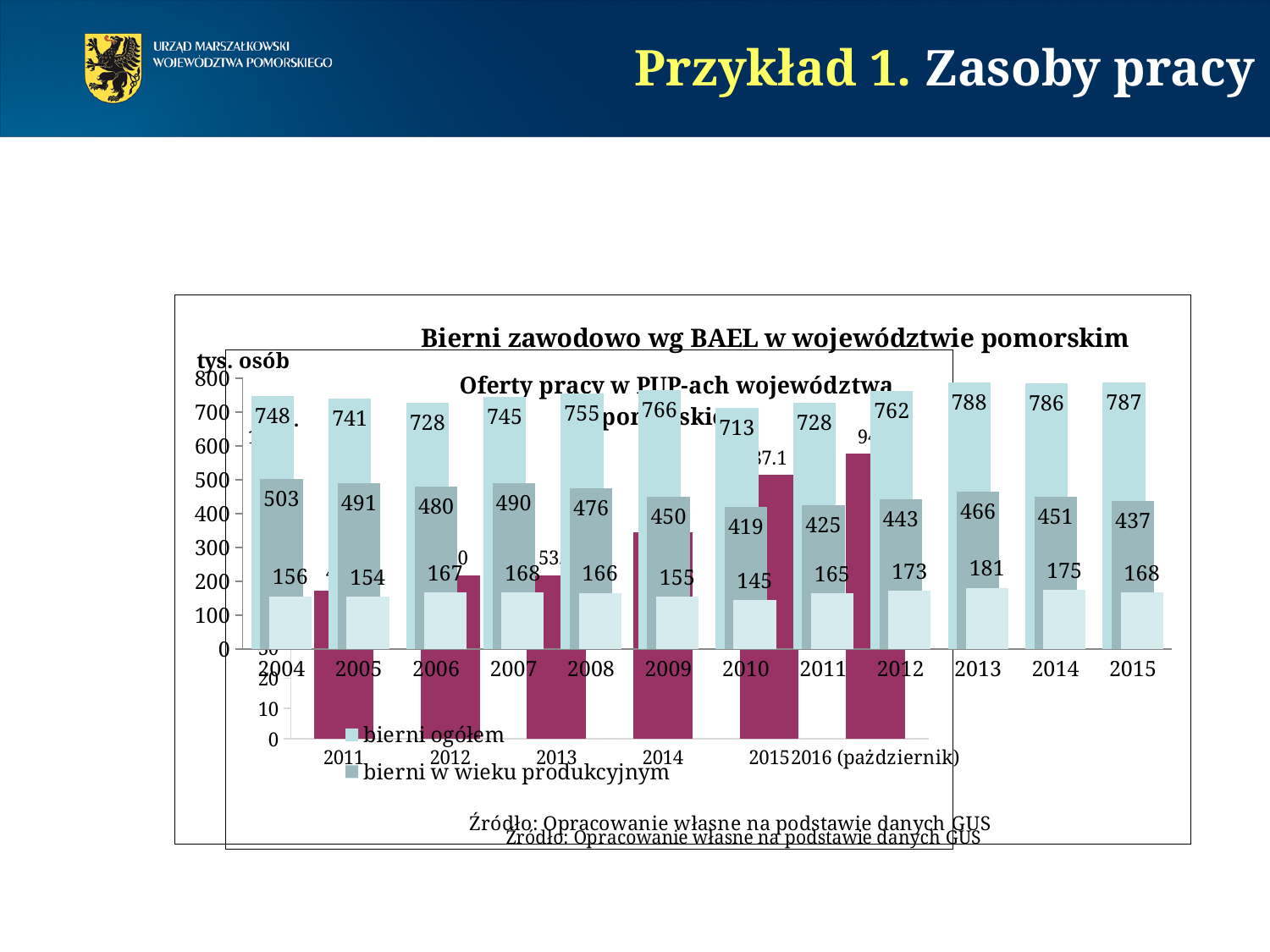
In the chart 'Bierni zawodowo wg BAEL w województwie pomorskim', is 'bierni w wieku produkcyjnym' larger in 2009 or in 2010? 2009 In the chart 'Bierni zawodowo wg BAEL w województwie pomorskim', what is the value of 'bierni w wieku produkcyjnym' for 2012? 443 In the chart 'Bierni zawodowo wg BAEL w województwie pomorskim', which year has the highest value of 'bierni w wieku produkcyjnym'? 2004 In the chart 'Bierni zawodowo wg BAEL w województwie pomorskim', what is the difference between 'bierni ogółem' in 2004 and in 2010? 35 In the chart 'Bierni zawodowo wg BAEL w województwie pomorskim', which year has the lowest value of 'bierni w wieku produkcyjnym'? 2010 In the chart 'Bierni zawodowo wg BAEL w województwie pomorskim', what is the value of 'bierni ogółem' for 2004? 748 In the chart 'Bierni zawodowo wg BAEL w województwie pomorskim', how many years are shown on the x axis? 12 In the chart 'Bierni zawodowo wg BAEL w województwie pomorskim', what unit is given on the vertical axis? tys. osób What kind of chart is 'Bierni zawodowo wg BAEL w województwie pomorskim'? bar chart In the chart 'Bierni zawodowo wg BAEL w województwie pomorskim', which year has the highest value of 'bierni ogółem'? 2013 In the chart 'Bierni zawodowo wg BAEL w województwie pomorskim', which year has the lowest value of 'bierni ogółem'? 2010 In the chart 'Bierni zawodowo wg BAEL w województwie pomorskim', what is the value of 'bierni ogółem' for 2015? 787